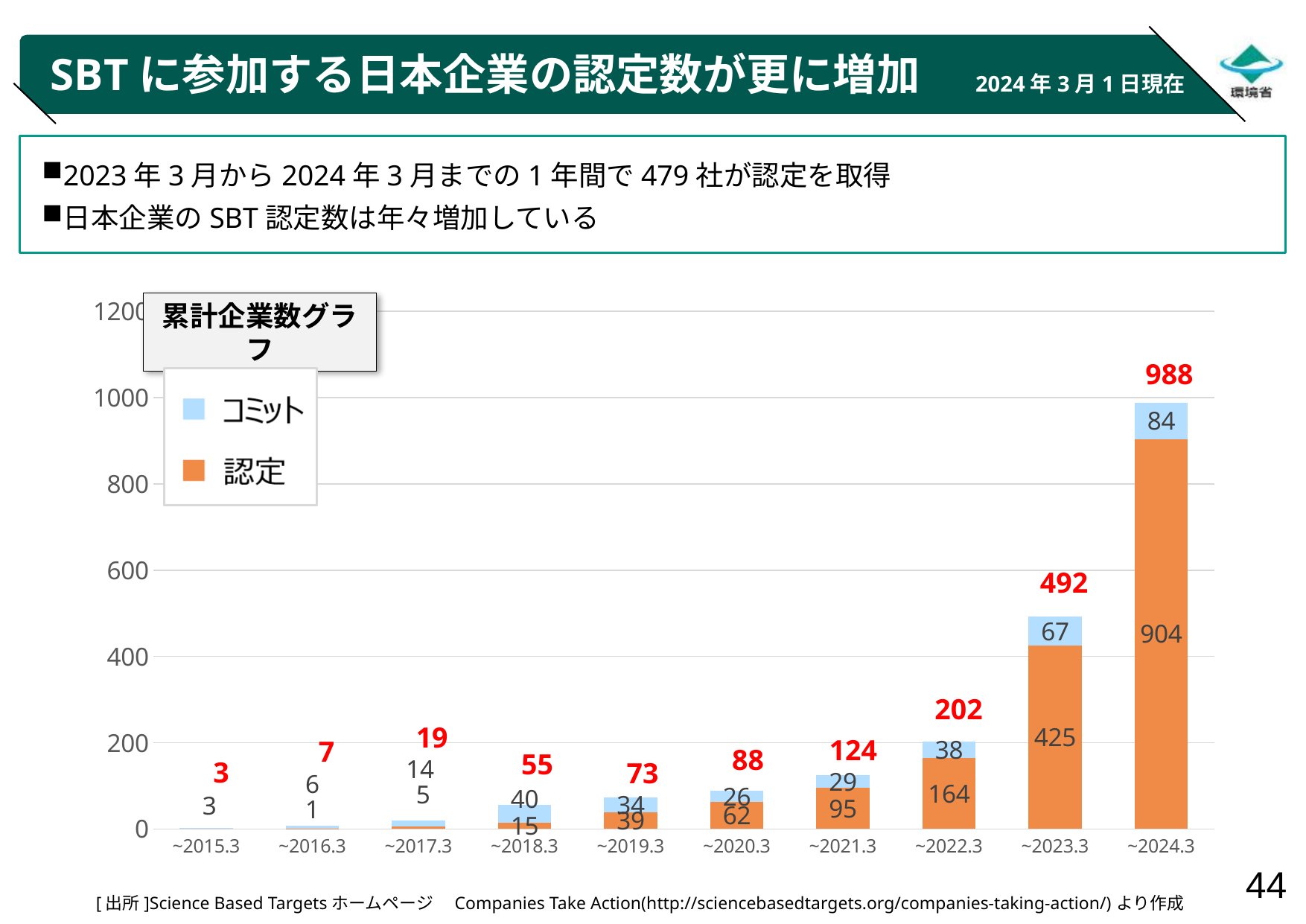
How many categories are shown on the x axis? 10 What is the total of the stacked bar for ~2023.3? 492 Which is larger for ~2020.3, the コミット value or the 認定 value? 認定 What kind of chart is shown on the slide? Stacked bar chart What is the 認定 value for ~2022.3? 164 What is the コミット value for ~2023.3? 67 What is the total of the stacked bar for ~2021.3? 124 Which category has the highest total? ~2024.3 What is the difference between the 認定 values for ~2024.3 and ~2023.3? 479 What is the 認定 value for ~2024.3? 904 How many series does the legend list? 2 Which category has the lowest total? ~2015.3